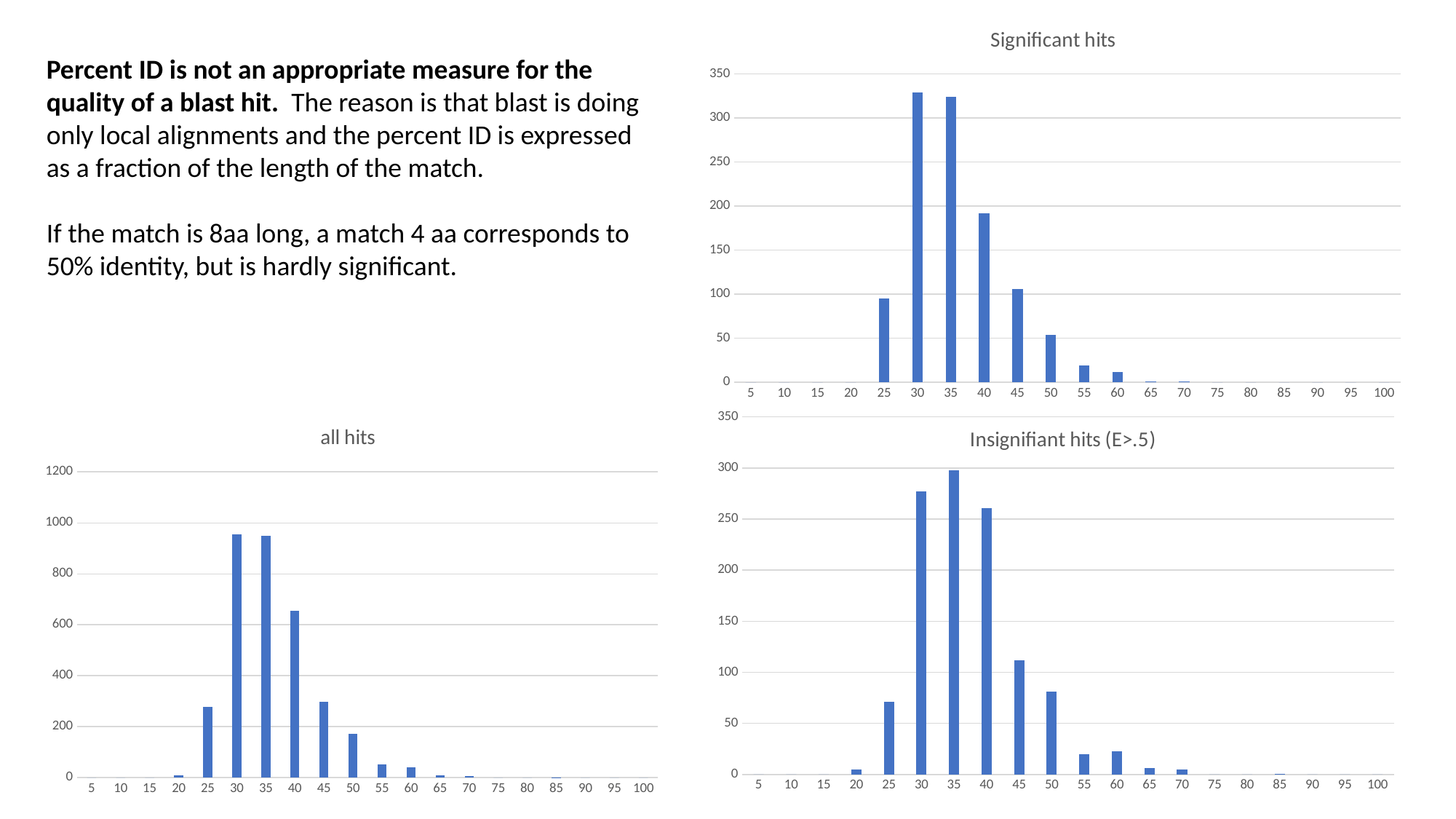
In the 'Insignifiant hits (E>.5)' chart, which is larger, the value for 30 or the value for 40? 30 In the 'all hits' chart, is the value for 50 greater or less than 200? less In the 'Insignifiant hits (E>.5)' chart, which category has the highest value? 35 In the 'all hits' chart, is the value for 40 greater or less than 600? greater How many charts are shown on the slide? 3 In the 'Significant hits' chart, is the value for 40 greater or less than 200? less How many categories are shown on the x axis of the 'all hits' chart? 20 In the 'Significant hits' chart, which is larger, the value for 40 or the value for 45? 40 What kind of chart is the 'Significant hits' chart? bar chart